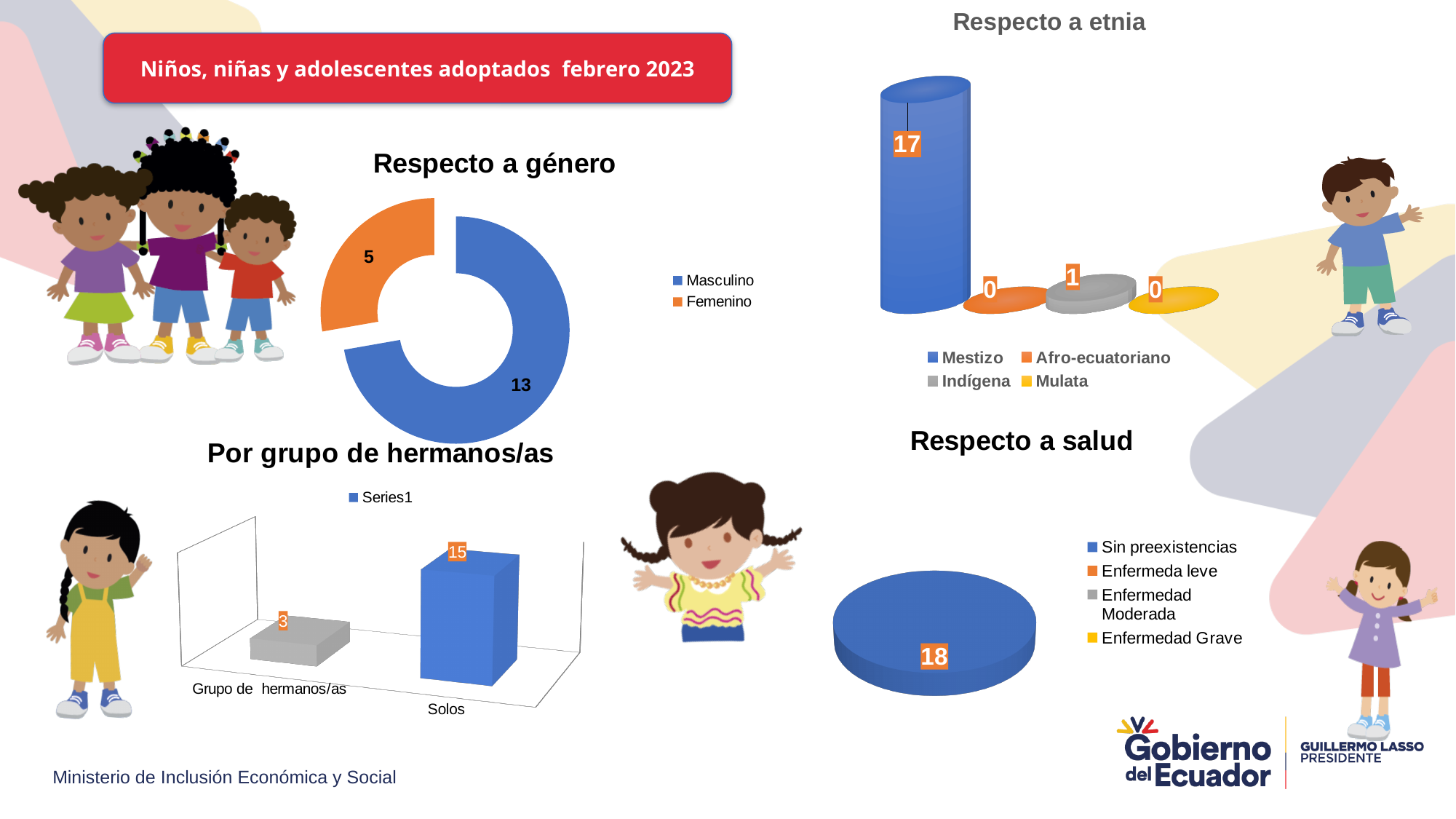
In the 'Respecto a etnia' chart, what is the value for Mestizo? 17 In the 'Por grupo de hermanos/as' chart, what is the value for Grupo de hermanos/as? 3 In the 'Por grupo de hermanos/as' chart, which is larger: Solos or Grupo de hermanos/as? Solos In the 'Respecto a etnia' chart, what is the value for Indígena? 1 How many series does the legend of the 'Respecto a etnia' chart list? 4 In the 'Respecto a género' chart, what is the difference between Masculino and Femenino? 8 In the 'Respecto a género' chart, what is the value for Masculino? 13 In the 'Respecto a salud' chart, what is the value for Sin preexistencias? 18 In the 'Respecto a género' chart, what share of the total does Femenino represent? 5 of 18 In the 'Por grupo de hermanos/as' chart, what is the value for Solos? 15 In the 'Respecto a género' chart, what is the value for Femenino? 5 In the 'Respecto a etnia' chart, which category has the highest value? Mestizo